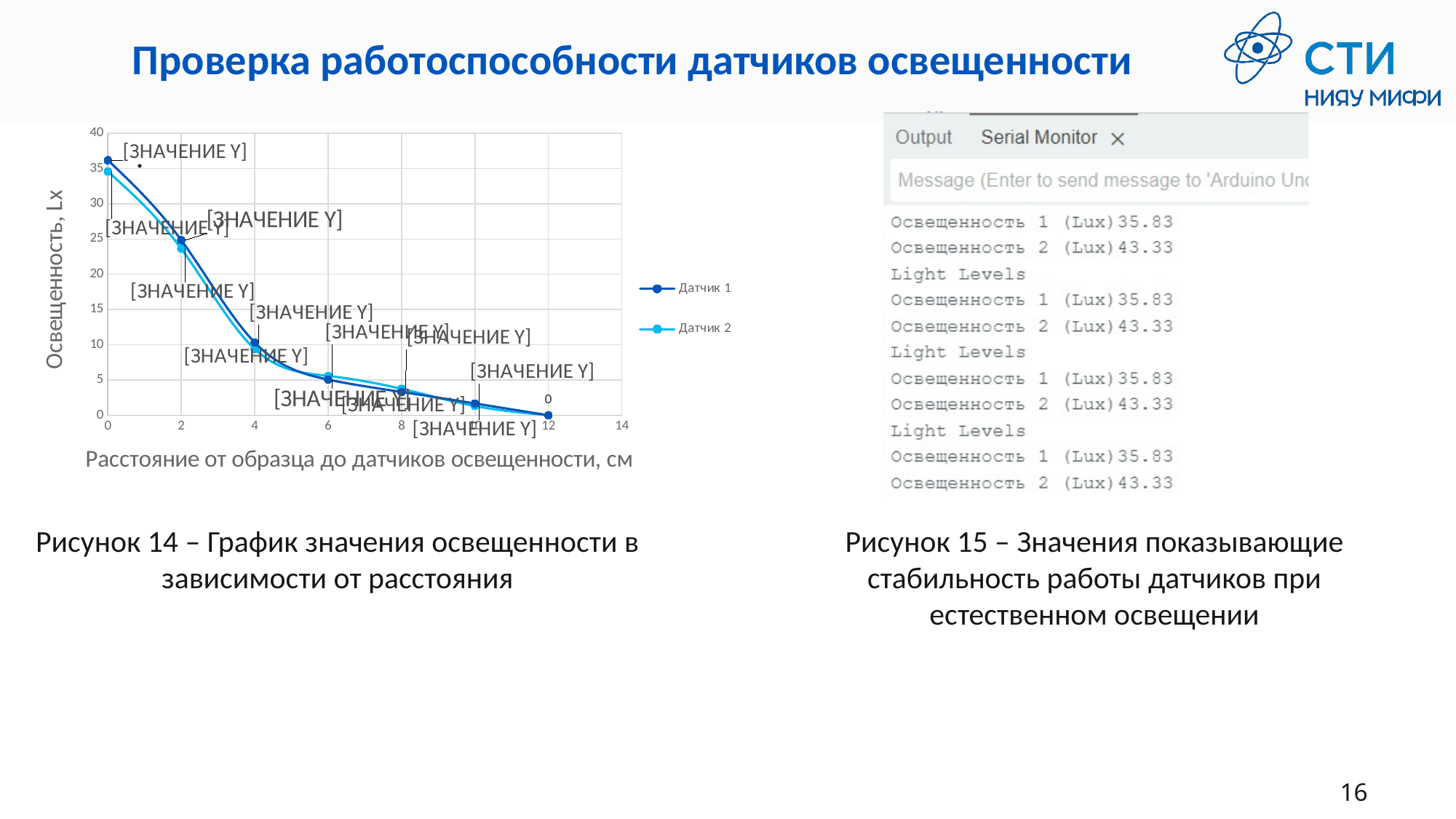
Is the value for Датчик 1 at distance 0 greater or less than 30? greater Do the illuminance values rise or fall as the distance increases along the x axis? fall At distance 0, which series has the larger value, Датчик 1 or Датчик 2? Датчик 1 At which distance is the Датчик 1 value highest? 0 How many series does the legend of the chart list? 2 What kind of chart is shown in Рисунок 14? line chart Is the value for Датчик 1 at distance 8 greater or less than 5? less How many data points are plotted for the Датчик 1 series? 7 What is the title of the y axis of the chart? Освещенность, Lx At which distance is the Датчик 2 value lowest? 12 What are the two series named in the chart legend? Датчик 1 and Датчик 2 Is the value for Датчик 2 at distance 2 greater or less than 25? less